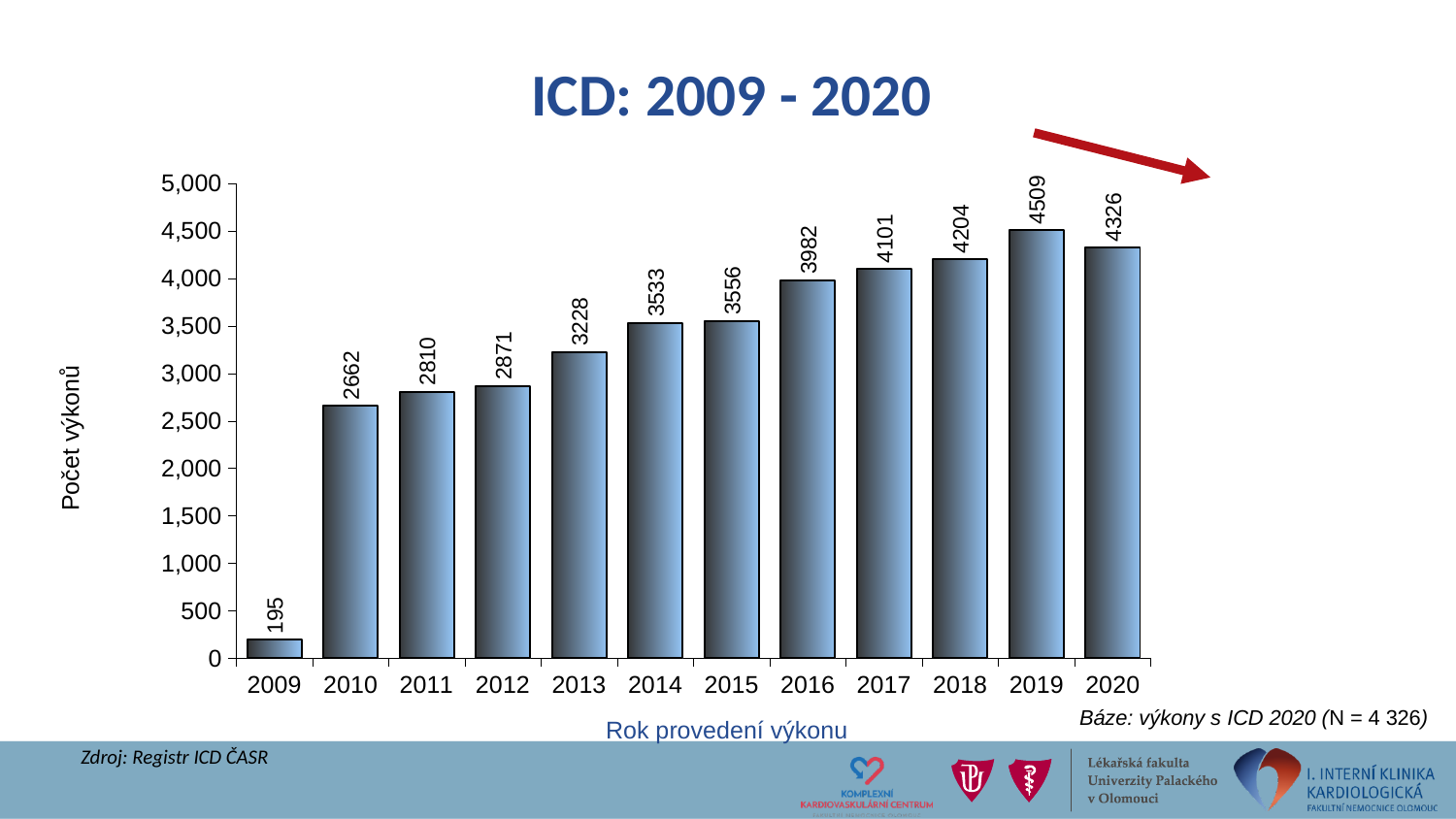
Which is larger, the value for 2013 or the value for 2016? 2016 Which year has the lowest value? 2009 What is the value for 2015? 3556 Is the value for 2017 greater or less than 4,000? greater How many years are shown on the x axis? 12 What is the value for 2009? 195 What is the value for 2020? 4326 Do the values generally rise or fall from 2009 to 2019? rise What is the difference between the values for 2019 and 2020? 183 Which year has the highest value? 2019 What kind of chart is this? bar chart What is the title of the chart? ICD: 2009 - 2020